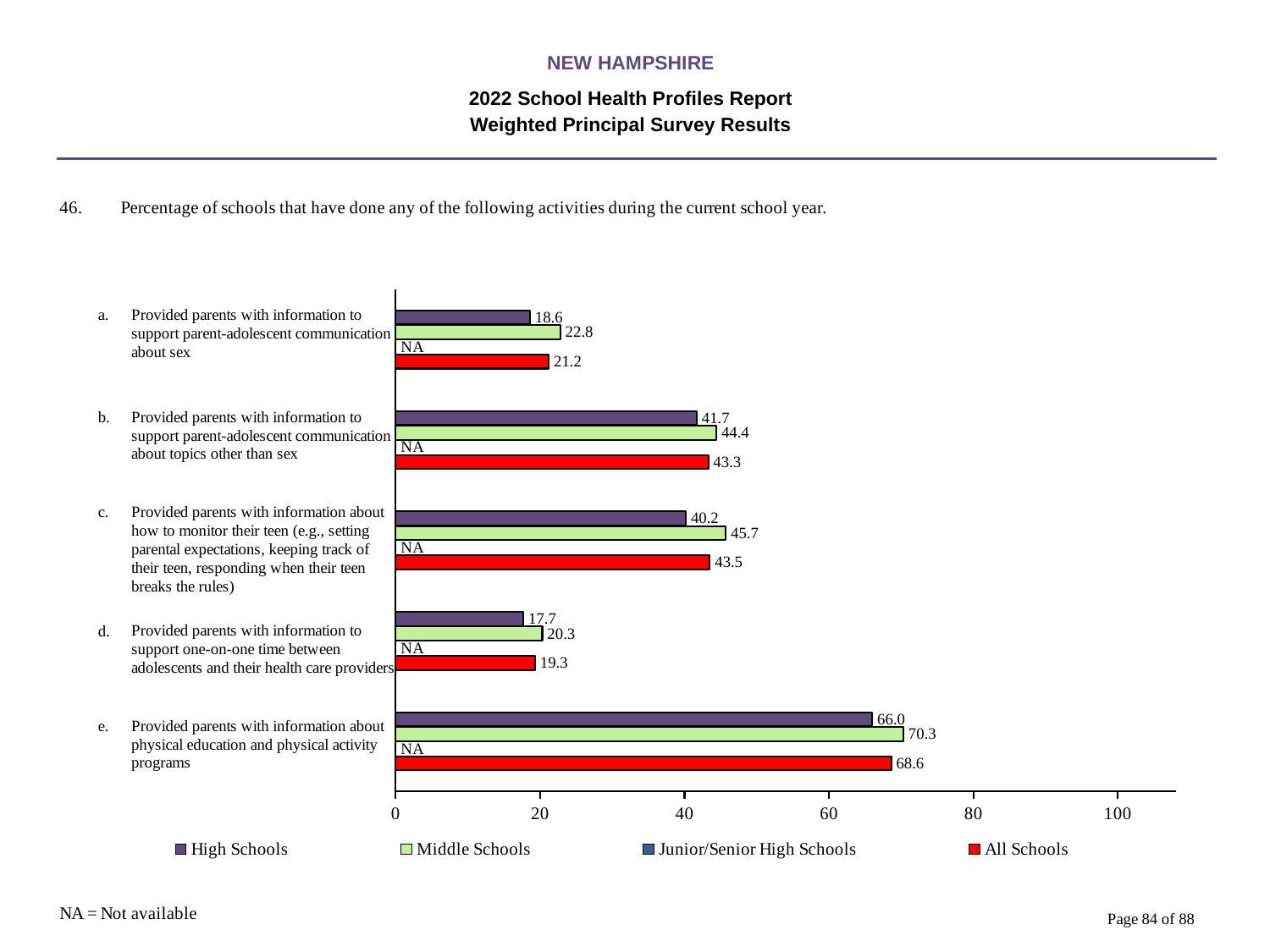
Is the All Schools value for activity e greater or less than 60? greater What is the difference between the Middle Schools and High Schools values for activity c? 5.5 What is the value for Middle Schools for activity a (information to support parent-adolescent communication about sex)? 22.8 What is the All Schools value for activity c (information about how to monitor their teen)? 43.5 What is the value for High Schools for activity e (information about physical education and physical activity programs)? 66.0 For activity b, which is larger: the High Schools value or the Middle Schools value? Middle Schools How many series does the legend list? 4 Which activity has the lowest High Schools value? d. Provided parents with information to support one-on-one time between adolescents and their health care providers How many activities (categories) are shown in the chart? 5 What value is shown for Junior/Senior High Schools for each activity? NA Which activity has the highest All Schools value? e. Provided parents with information about physical education and physical activity programs What kind of chart is shown on the slide? bar chart